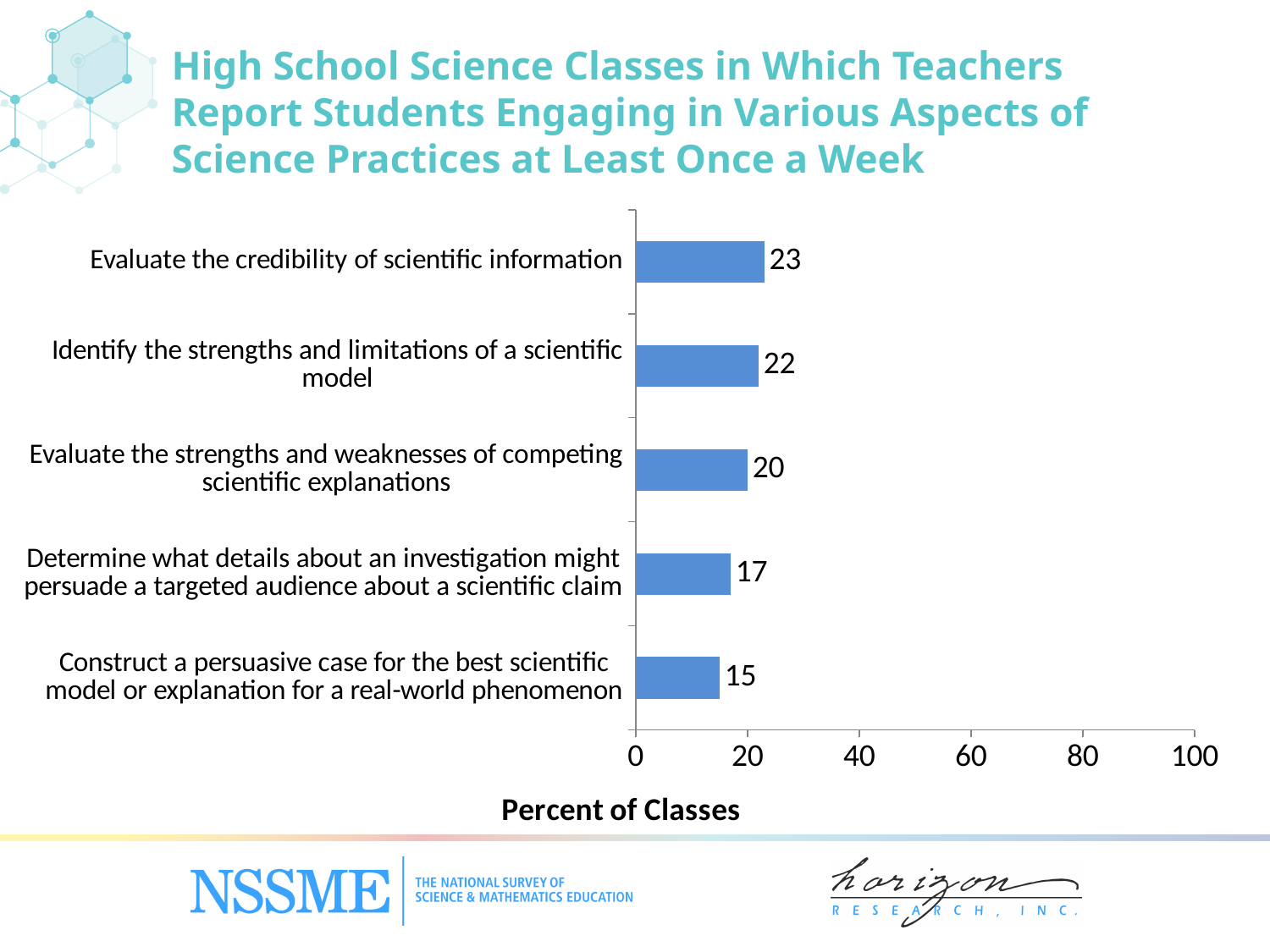
Which category has the highest percent of classes? Evaluate the credibility of scientific information What is the value for "Construct a persuasive case for the best scientific model or explanation for a real-world phenomenon"? 15 What kind of chart is shown on the slide? bar chart What percent of classes is reported for "Evaluate the credibility of scientific information"? 23 Which category has the lowest percent of classes? Construct a persuasive case for the best scientific model or explanation for a real-world phenomenon Is the value for "Evaluate the credibility of scientific information" greater or less than 40? less What is the label of the horizontal axis? Percent of Classes What is the difference between the values for "Evaluate the credibility of scientific information" and "Construct a persuasive case for the best scientific model or explanation for a real-world phenomenon"? 8 What is the maximum value shown on the horizontal axis? 100 How many categories are shown in the chart? 5 Which is larger: the value for "Identify the strengths and limitations of a scientific model" or for "Evaluate the strengths and weaknesses of competing scientific explanations"? Identify the strengths and limitations of a scientific model What is the value for "Determine what details about an investigation might persuade a targeted audience about a scientific claim"? 17